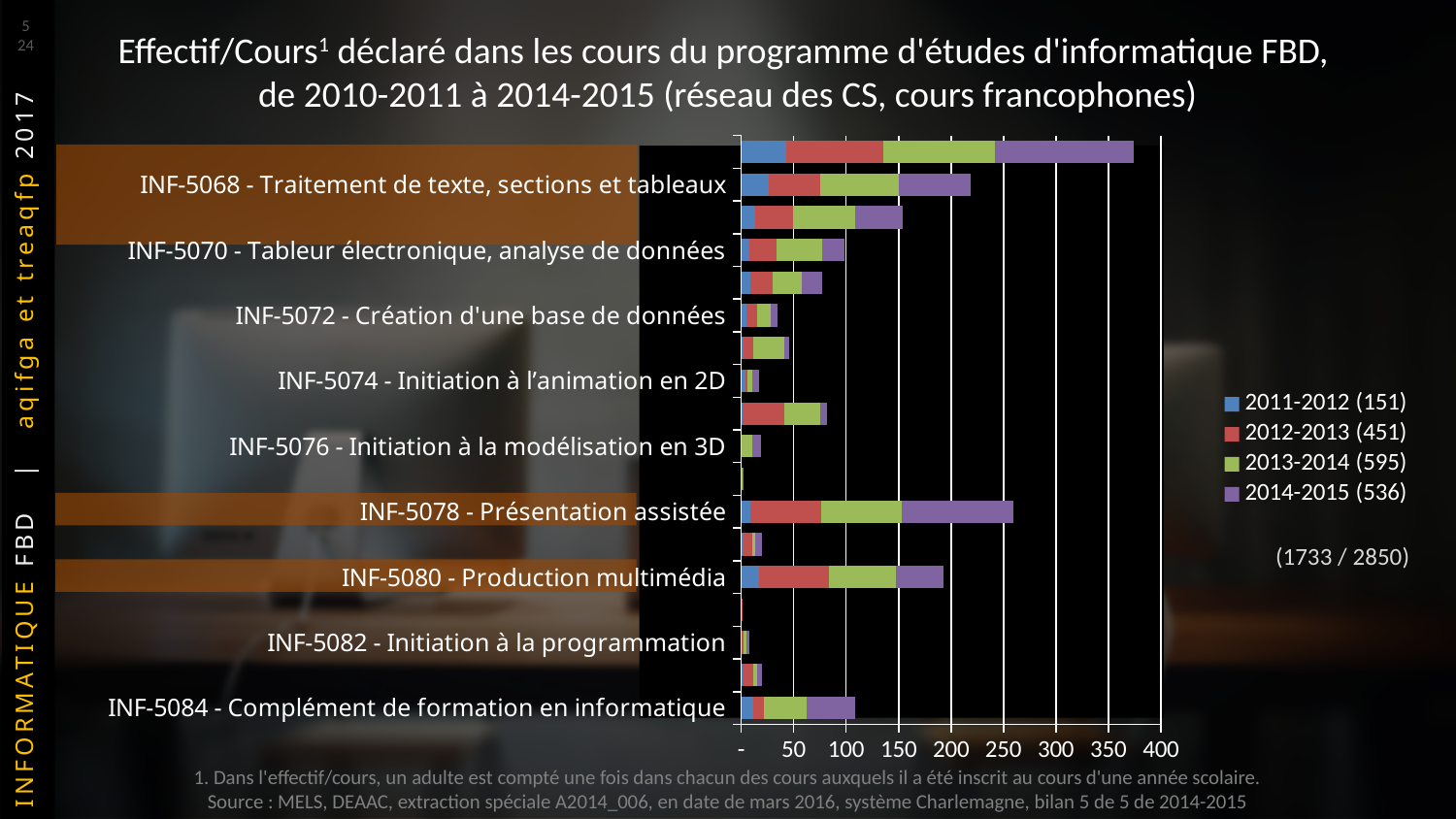
What kind of chart is shown on the slide? stacked bar chart What is the highest value shown on the horizontal axis? 400 How many series does the legend list? 4 Is the total bar length for INF-5070 - Tableur électronique, analyse de données greater or less than 150? less Is the total bar length for INF-5078 - Présentation assistée greater or less than 200? greater Which has the longer total bar, INF-5078 - Présentation assistée or INF-5080 - Production multimédia? INF-5078 - Présentation assistée What total is shown in parentheses next to the legend entry 2011-2012? 151 According to the legend totals, which school year has the highest total? 2013-2014 According to the legend totals, which school year has the lowest total? 2011-2012 What total is shown in parentheses next to the legend entry 2013-2014? 595 What is the difference between the legend totals for 2013-2014 and 2014-2015? 59 Which school year does the first legend entry refer to? 2011-2012